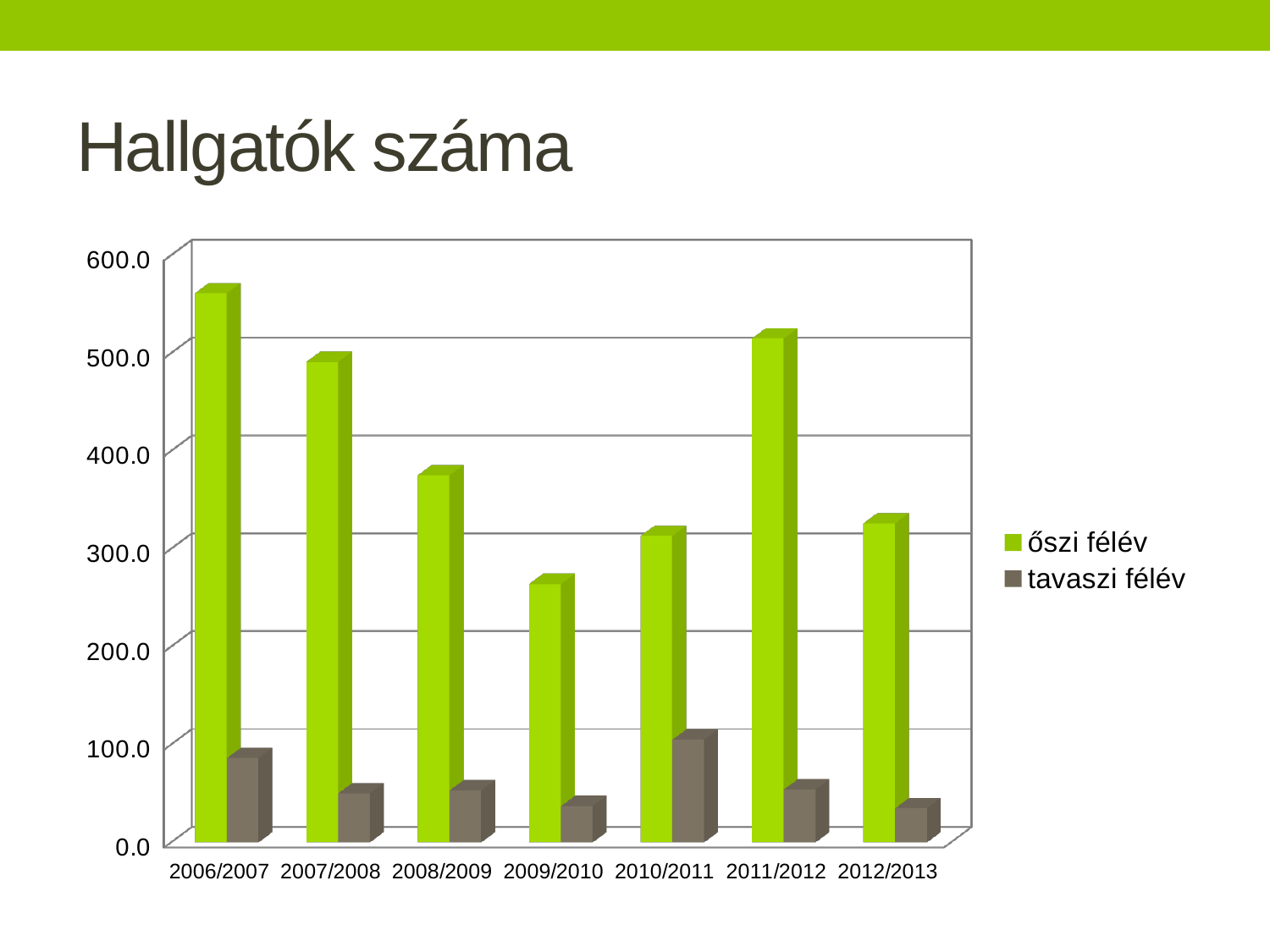
What type of chart is shown on the slide? bar chart Which academic year has the highest value for őszi félév? 2006/2007 Is the őszi félév value for 2006/2007 greater or less than 500? greater Which is larger, the őszi félév value for 2011/2012 or for 2012/2013? 2011/2012 Do the őszi félév values rise or fall from 2006/2007 to 2009/2010? fall Which academic year has the lowest value for őszi félév? 2009/2010 Is the tavaszi félév value for 2006/2007 greater or less than 100? less Which academic year has the highest value for tavaszi félév? 2010/2011 How many academic years are shown on the x axis? 7 Is the őszi félév value for 2009/2010 greater or less than 300? less How many series does the legend list? 2